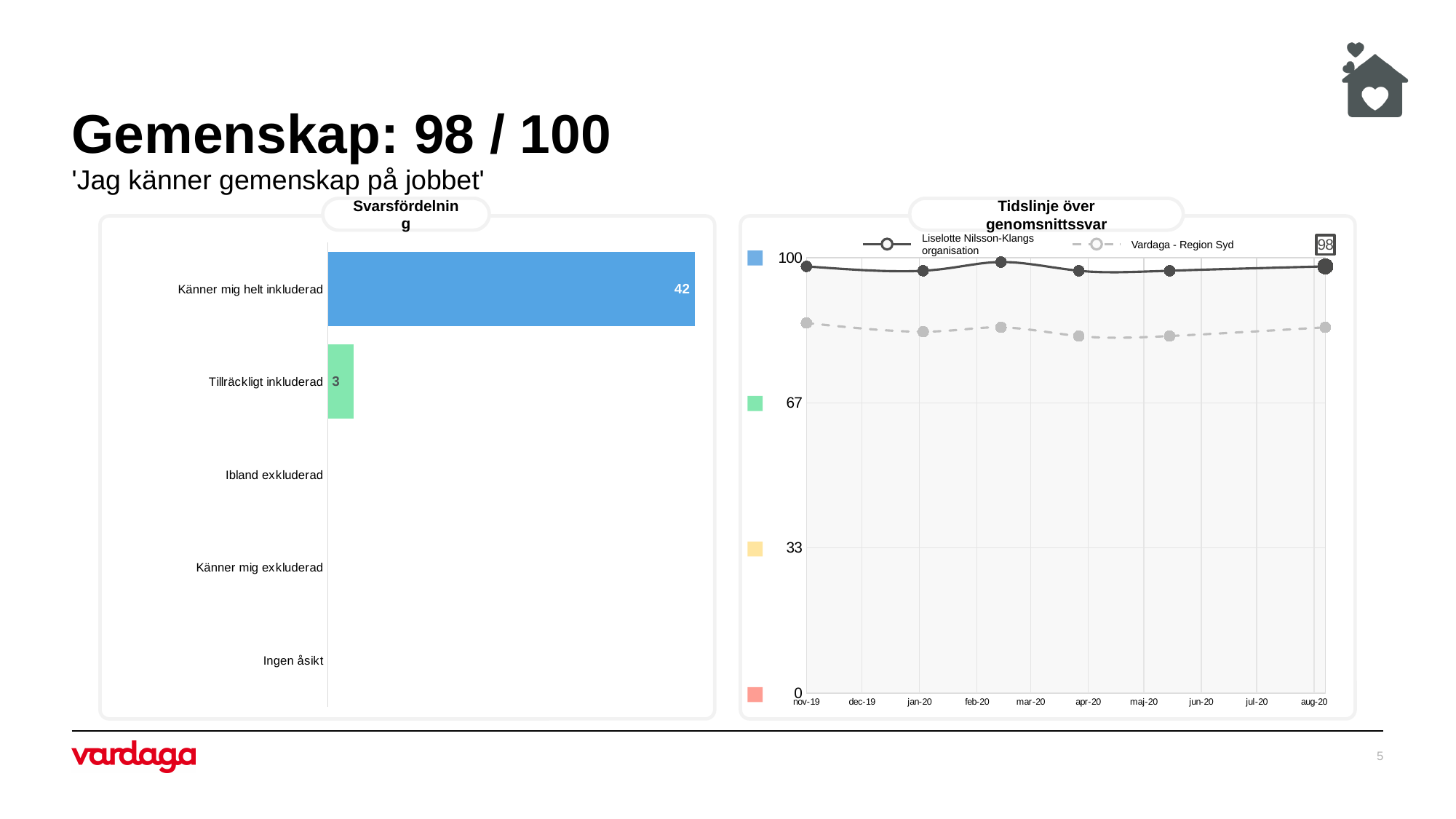
In the Svarsfördelning chart, what is the value for 'Tillräckligt inkluderad'? 3 In the Svarsfördelning chart, which category has the highest value? Känner mig helt inkluderad How many series does the legend of the Tidslinje över genomsnittssvar chart list? 2 In the Svarsfördelning chart, what is the difference between 'Känner mig helt inkluderad' and 'Tillräckligt inkluderad'? 39 How many categories are listed on the Svarsfördelning chart? 5 In the Svarsfördelning chart, which is larger: 'Känner mig helt inkluderad' or 'Tillräckligt inkluderad'? Känner mig helt inkluderad In the Tidslinje över genomsnittssvar chart, which series is higher at aug-20: Liselotte Nilsson-Klangs organisation or Vardaga - Region Syd? Liselotte Nilsson-Klangs organisation What kind of chart is the Svarsfördelning chart? Bar chart In the Svarsfördelning chart, what is the value for 'Känner mig helt inkluderad'? 42 In the Tidslinje över genomsnittssvar chart, is the value for Vardaga - Region Syd at aug-20 greater or less than 67? greater In the Tidslinje över genomsnittssvar chart, what is the value labelled for aug-20 on the Liselotte Nilsson-Klangs organisation series? 98 What kind of chart is the Tidslinje över genomsnittssvar chart? Line chart